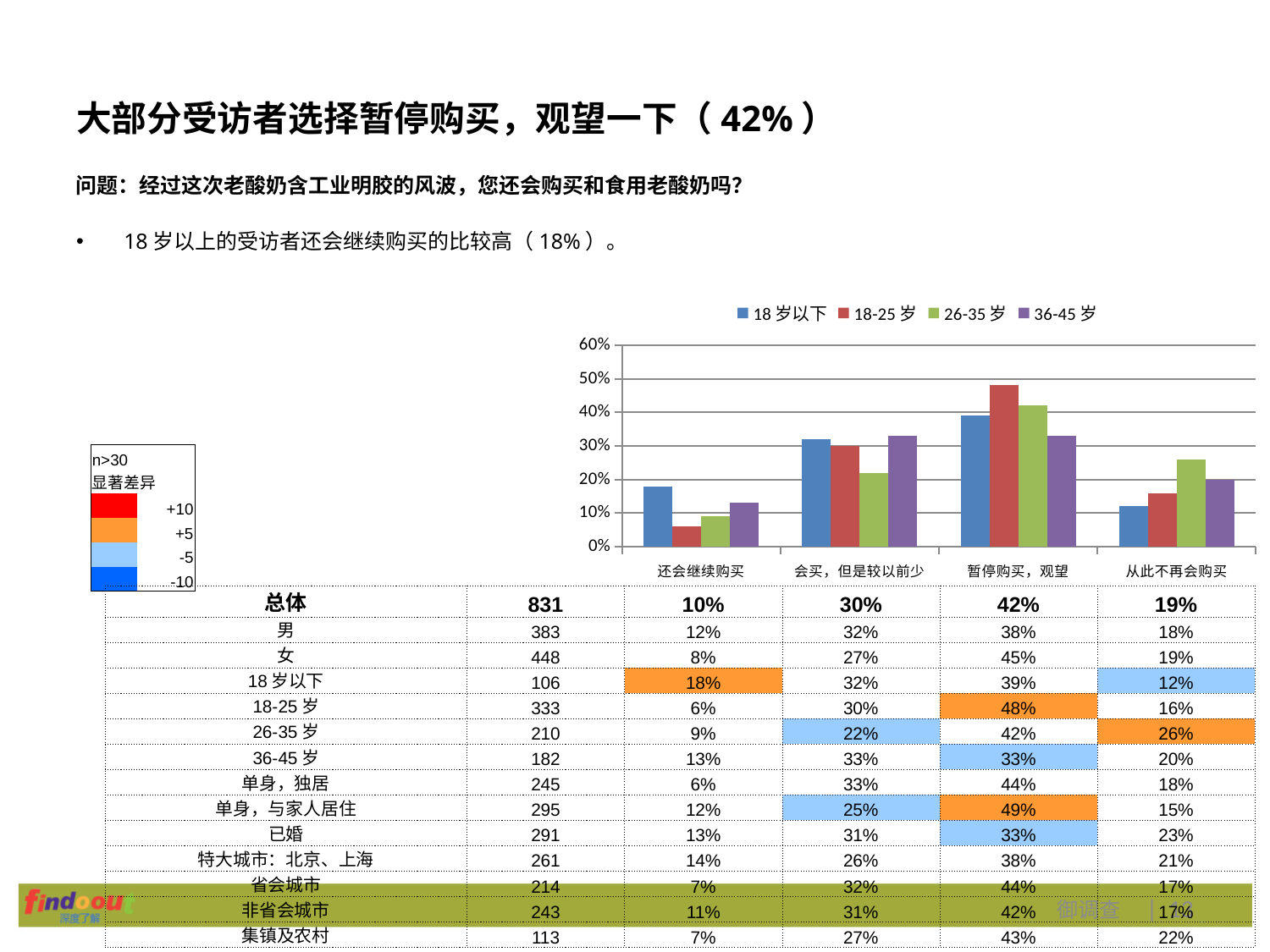
Which response category has the tallest bars overall in the chart? 暂停购买，观望 Is the value for 18 岁以下 under 还会继续购买 greater or less than 10%? greater For 从此不再会购买, which is larger: the bar for 26-35 岁 or the bar for 36-45 岁? 26-35 岁 What colour represents the 18-25 岁 series in the chart? red How many response categories are shown along the x axis of the chart? 4 Which age group has the highest bar for 暂停购买，观望? 18-25 岁 According to the slide, what is the value for 26-35 岁 under 从此不再会购买? 26% Which age group has the lowest bar for 还会继续购买? 18-25 岁 What kind of chart is shown on the slide? bar chart Is the value for 18-25 岁 under 暂停购买，观望 greater or less than 40%? greater According to the slide, what is the value for 18-25 岁 under 暂停购买，观望? 48% How many series does the chart legend list? 4